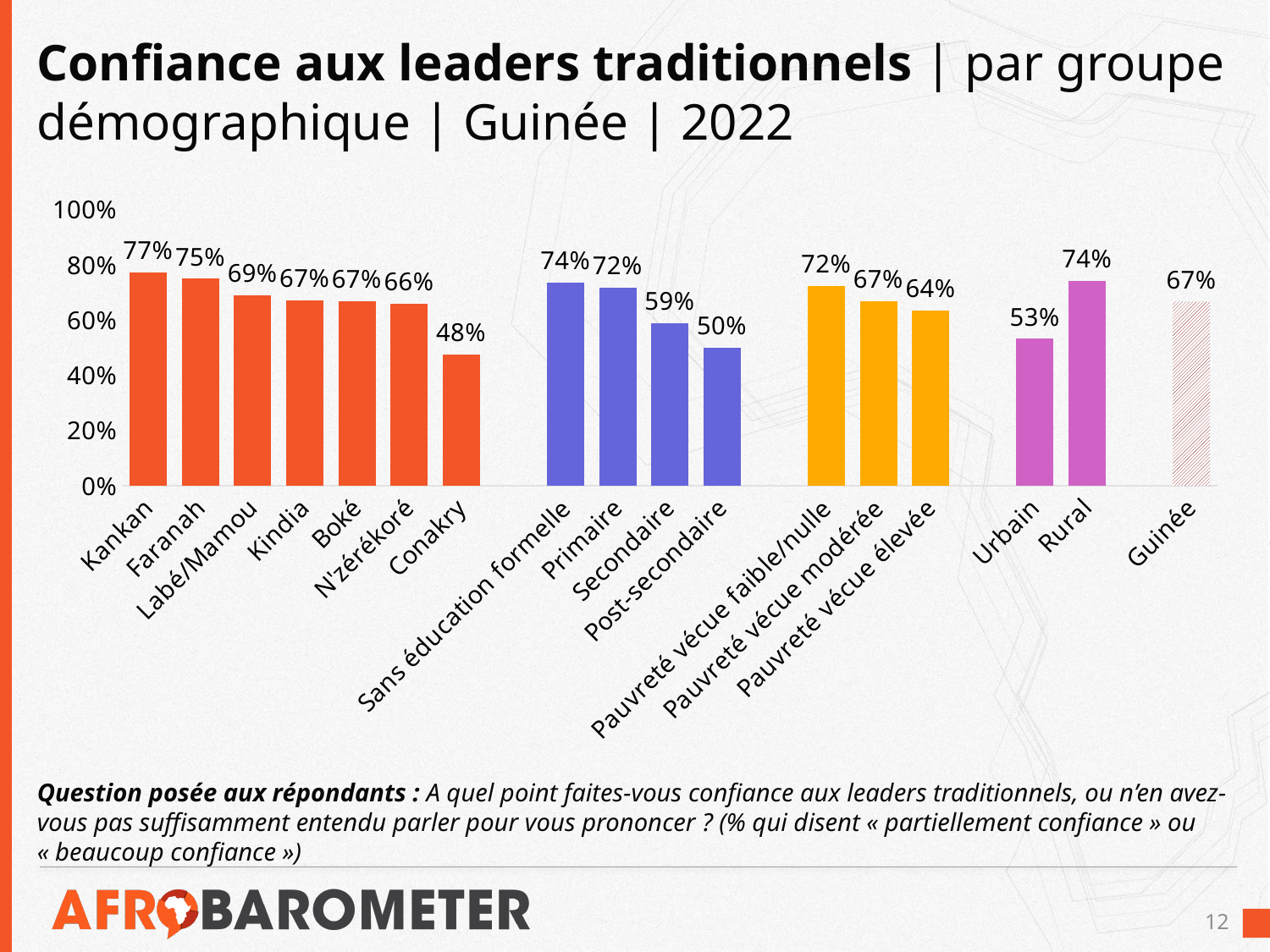
Is the value for Pauvreté vécue élevée greater or less than 60%? greater How many categories are shown on the chart? 17 Which category has the highest value on the chart? Kankan What is the value for Post-secondaire? 50% What kind of chart is shown on the slide? bar chart What is the value for Conakry? 48% Which category has the lowest value on the chart? Conakry What is the value for Rural? 74% What is the value for Guinée overall? 67% What is the value for Kankan? 77% What is the difference between the values for Rural and Urbain? 21% Which is larger, the value for Sans éducation formelle or the value for Secondaire? Sans éducation formelle